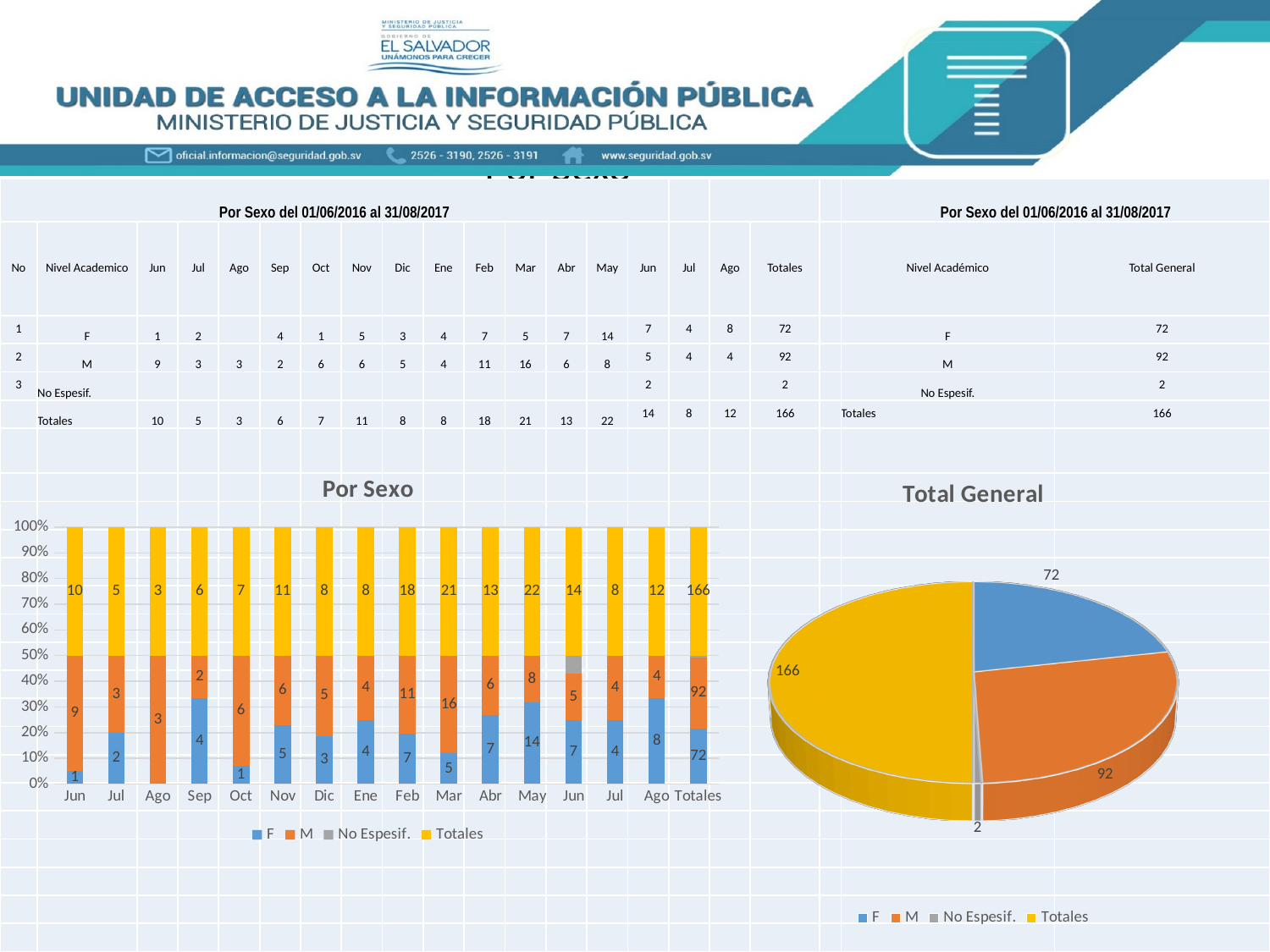
What kind of chart is the 'Total General' chart? Pie chart What kind of chart is the 'Por Sexo' chart? Bar chart In the 'Por Sexo' chart, what is the value of the M series for Mar? 16 In the 'Por Sexo' chart, what is the value of the F series for May? 14 How many series does the legend of the 'Por Sexo' chart list? 4 In the 'Por Sexo' chart, what is the Totales value for Feb? 18 In the 'Por Sexo' chart, which is larger for Jun (the first Jun), the F value or the M value? M In the 'Total General' chart, what is the value of the M slice? 92 How many categories are shown on the x axis of the 'Por Sexo' chart? 16 In the 'Por Sexo' chart, among the monthly categories, which has the highest Totales value? May In the 'Por Sexo' chart, what is the difference between the M value and the F value for Mar? 11 In the 'Total General' chart, which slice has the smallest value? No Espesif.